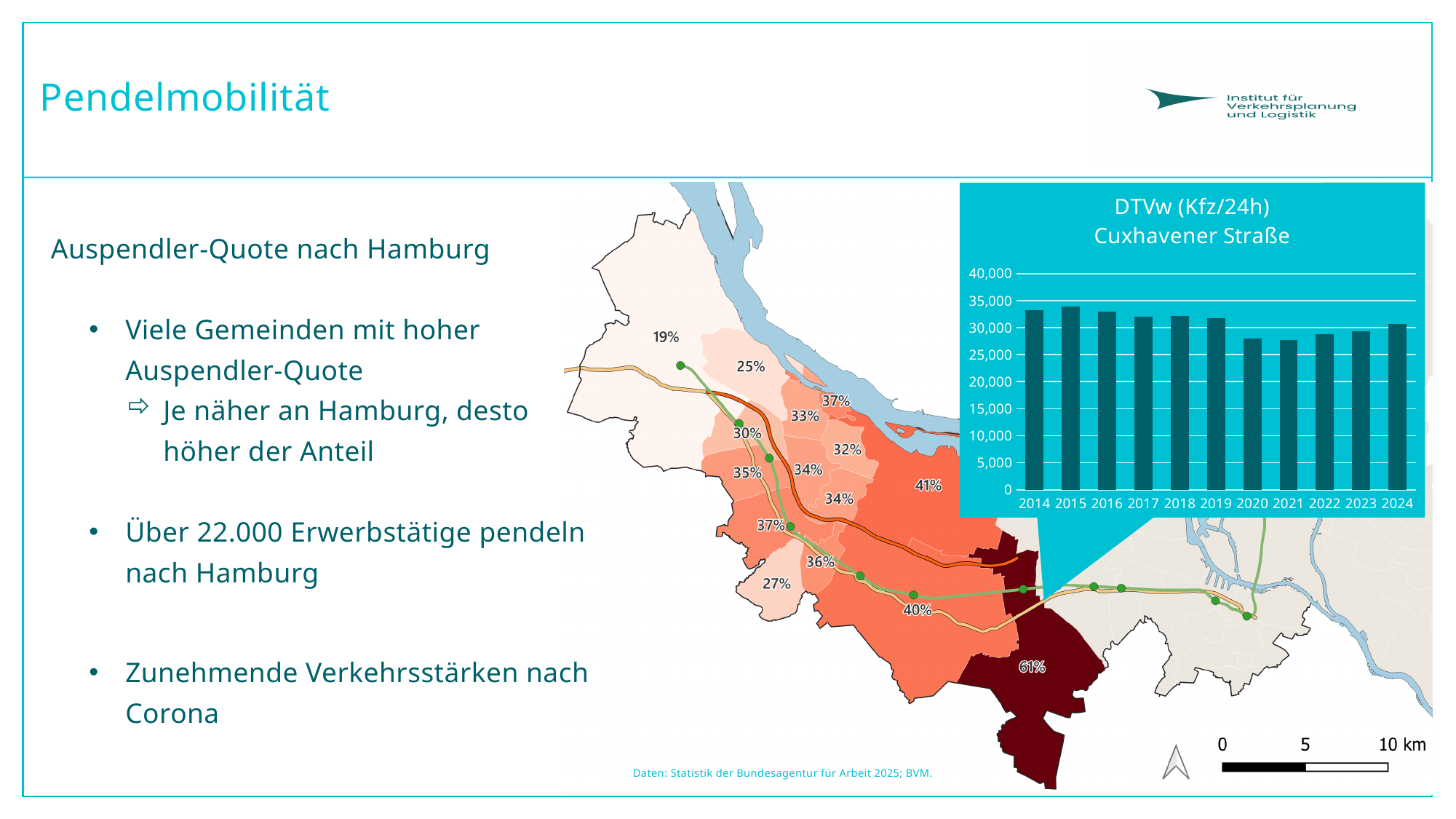
What is the first year shown on the x axis of the 'DTVw (Kfz/24h) Cuxhavener Straße' chart? 2014 In the 'DTVw (Kfz/24h) Cuxhavener Straße' chart, is the value for 2015 greater or less than 35,000? less How many years are plotted in the 'DTVw (Kfz/24h) Cuxhavener Straße' chart? 11 What is the highest tick value on the y axis of the 'DTVw (Kfz/24h) Cuxhavener Straße' chart? 40,000 In the 'DTVw (Kfz/24h) Cuxhavener Straße' chart, is the value for 2021 greater or less than 25,000? greater In the 'DTVw (Kfz/24h) Cuxhavener Straße' chart, which year has the larger value, 2014 or 2020? 2014 What kind of chart is shown in the 'DTVw (Kfz/24h) Cuxhavener Straße' panel? bar chart In the 'DTVw (Kfz/24h) Cuxhavener Straße' chart, which year has the larger value, 2019 or 2021? 2019 In the 'DTVw (Kfz/24h) Cuxhavener Straße' chart, do the values rise or fall from 2021 to 2024? rise In the 'DTVw (Kfz/24h) Cuxhavener Straße' chart, is the value for 2020 greater or less than 30,000? less In the 'DTVw (Kfz/24h) Cuxhavener Straße' chart, do the values rise or fall from 2016 to 2021? fall